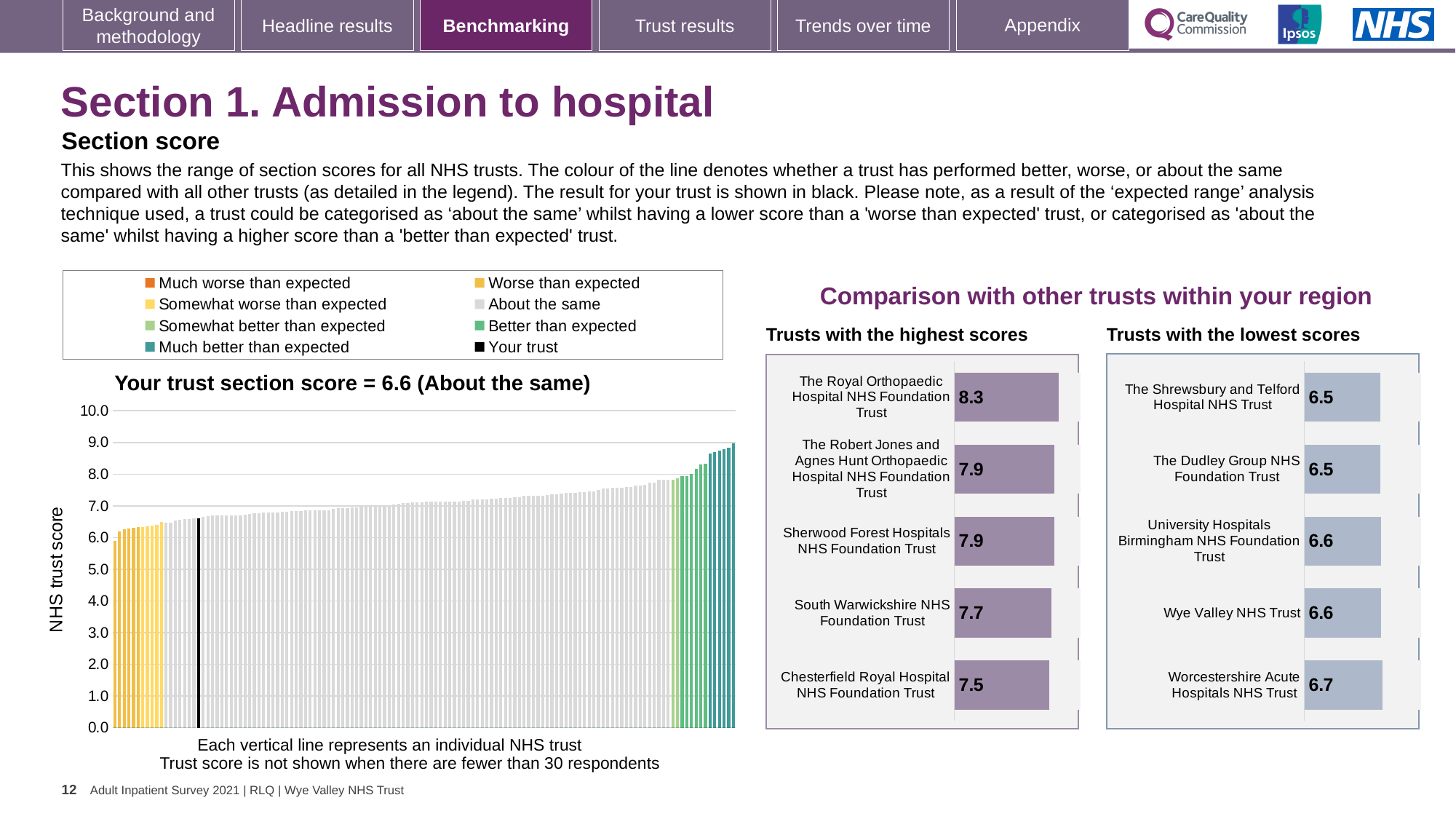
On the 'Your trust section score' chart, how many entries does the legend list? 8 On the 'Your trust section score' chart, do the bars rise or fall from left to right? rise On the 'Trusts with the lowest scores' chart, which trust has the highest score? Worcestershire Acute Hospitals NHS Trust On the 'Trusts with the highest scores' chart, what is the difference between the scores of The Royal Orthopaedic Hospital NHS Foundation Trust and Chesterfield Royal Hospital NHS Foundation Trust? 0.8 On the 'Trusts with the highest scores' chart, how many trusts are shown? 5 On the 'Trusts with the lowest scores' chart, what is the score for Wye Valley NHS Trust? 6.6 On the 'Your trust section score' chart, is the value of the tallest bar greater or less than 8.0? greater On the 'Your trust section score' chart, what is the section score for your trust? 6.6 On the 'Trusts with the highest scores' chart, what is the score for Chesterfield Royal Hospital NHS Foundation Trust? 7.5 On the 'Your trust section score' chart, what kind of chart is shown? bar chart On the 'Your trust section score' chart, what is the label on the vertical axis? NHS trust score On the 'Trusts with the highest scores' chart, which trust has the highest score? The Royal Orthopaedic Hospital NHS Foundation Trust